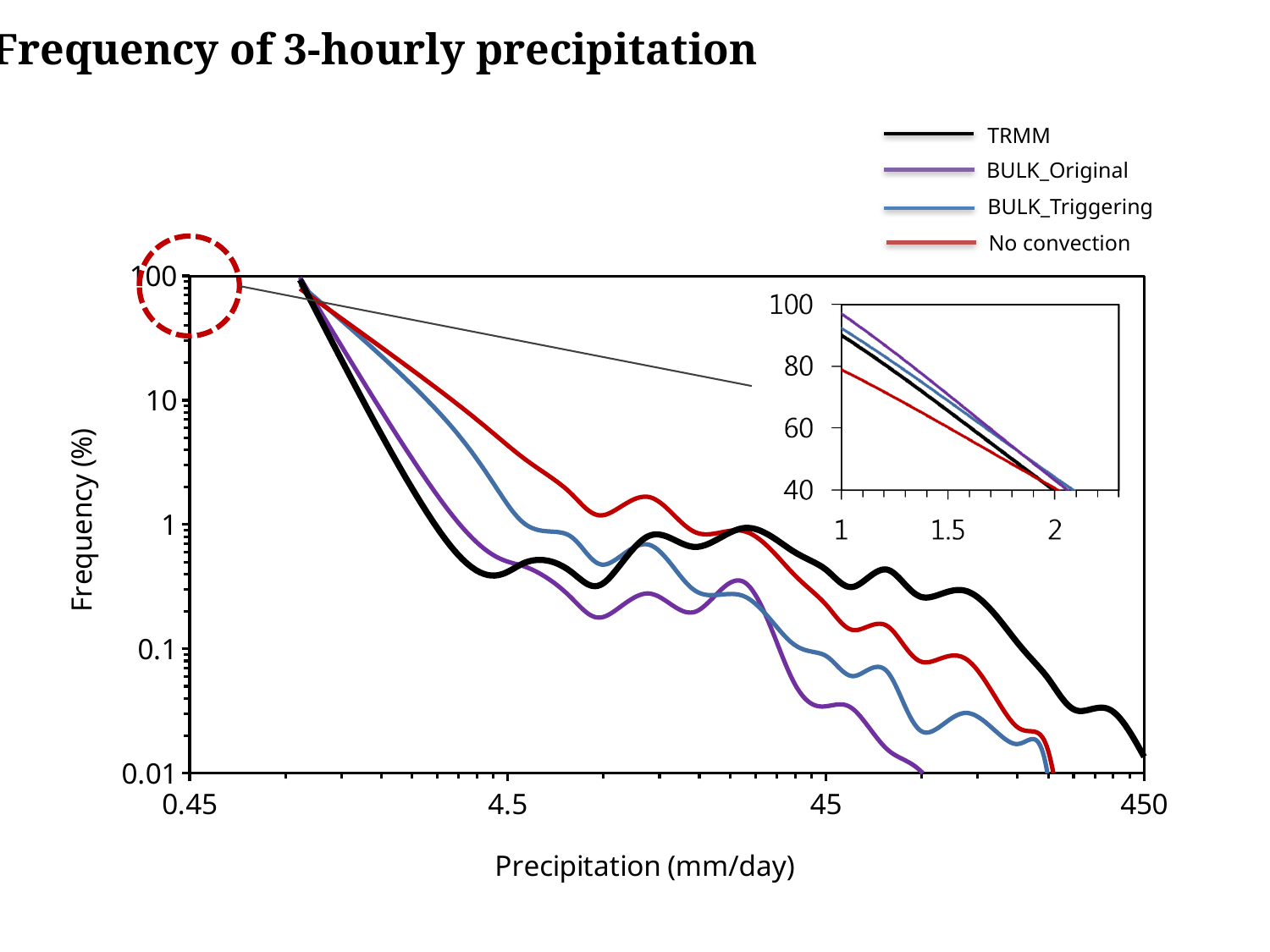
Overall, does frequency rise or fall as precipitation increases along the x axis? fall What are the four series named in the legend? TRMM, BULK_Original, BULK_Triggering, No convection Is the TRMM frequency at 45 mm/day greater or less than 1%? less At 4.5 mm/day, which series has the higher frequency, No convection or TRMM? No convection Which series extends farthest to the right, reaching 450 mm/day on the x axis? TRMM Is the BULK_Original frequency at 45 mm/day greater or less than 0.1%? less In the inset panel, which series has the highest frequency at a precipitation of 1 mm/day? BULK_Original Is the No convection frequency at 4.5 mm/day greater or less than 1%? greater What kind of chart is shown on the slide? line chart At 45 mm/day, which series has the higher frequency, TRMM or BULK_Original? TRMM How many series does the legend list? 4 In the inset panel, which series has the lowest frequency at a precipitation of 1 mm/day? No convection